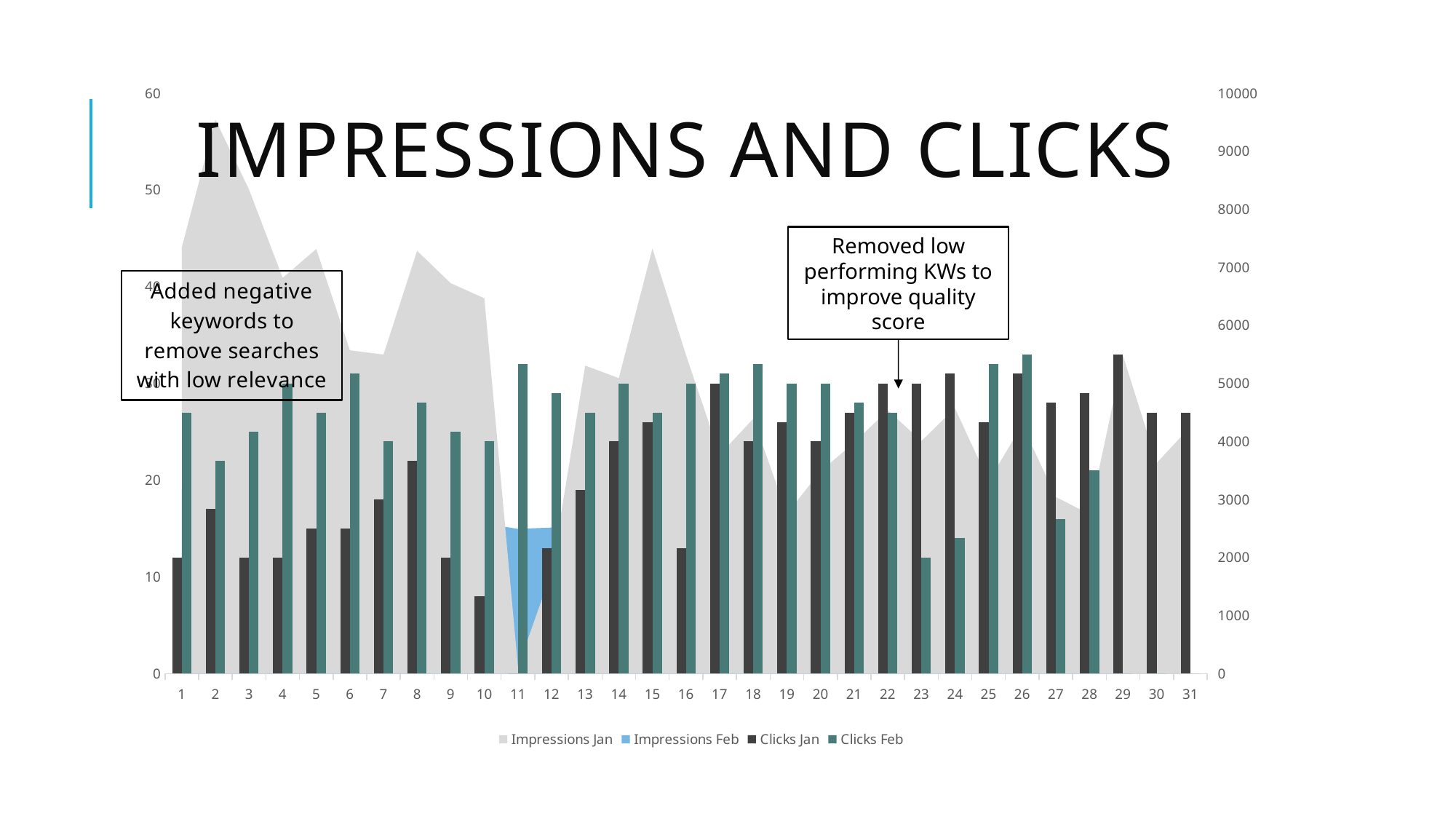
On day 23, which is larger: Clicks Jan or Clicks Feb? Clicks Jan On day 1, which is larger: Clicks Jan or Clicks Feb? Clicks Feb Is the Clicks Jan value for day 29 greater or less than 30? greater How many days (categories) are shown on the x axis? 31 How many series does the legend list? 4 Is the Clicks Feb value for day 11 greater or less than 30? greater Is the Clicks Jan value for day 10 greater or less than 10? less What kind of chart is this? Combination of area chart and bar chart Which day has the lowest Clicks Jan value? 11 Which day has the highest Clicks Jan value? 29 What is the title of the chart? IMPRESSIONS AND CLICKS